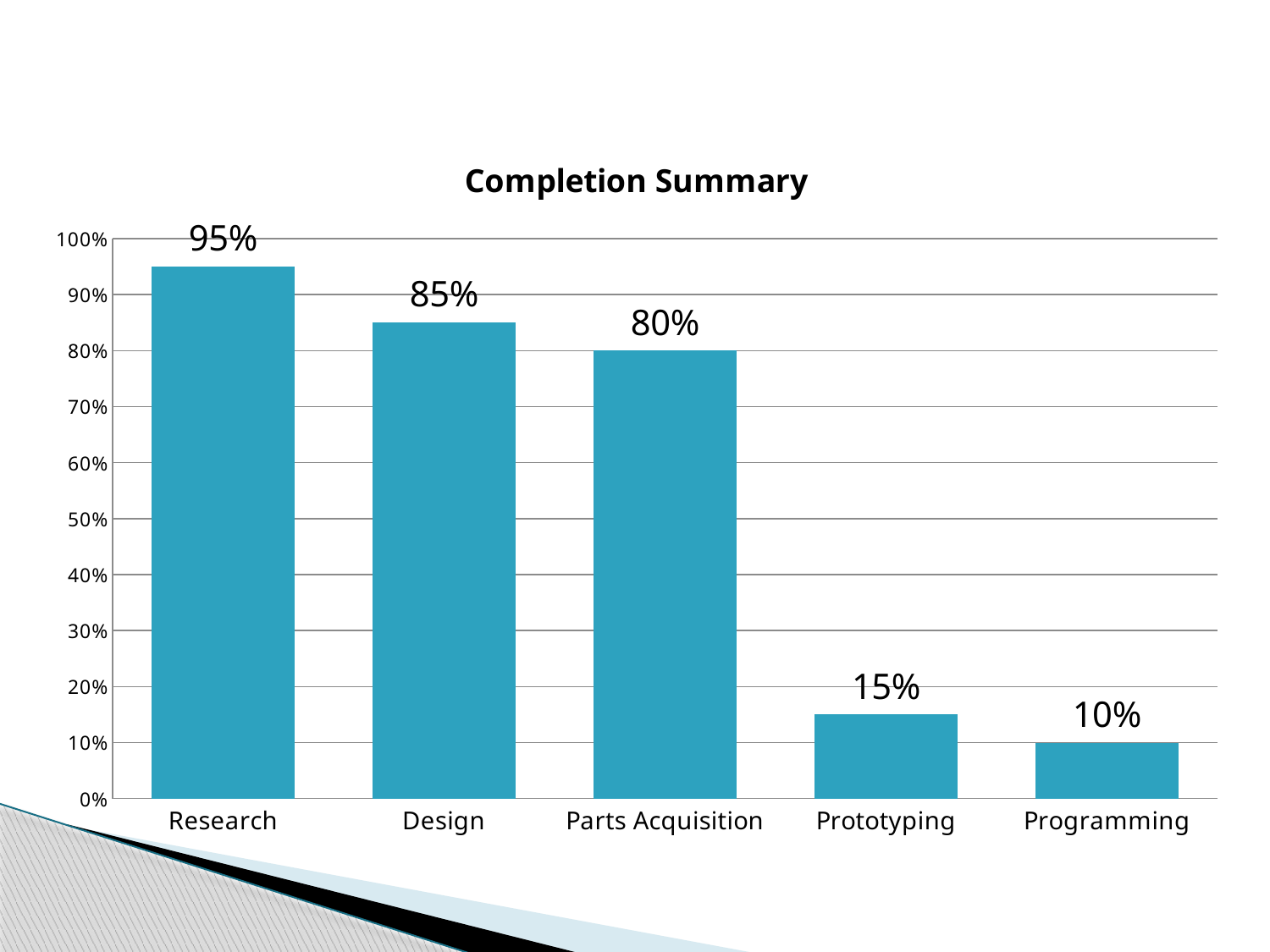
Which is larger, the value for Design or the value for Prototyping? Design What is the completion value for Parts Acquisition? 80% Which category has the highest completion value? Research What is the difference between the values for Design and Parts Acquisition? 5% What is the completion value for Prototyping? 15% What is the title of the chart? Completion Summary How many categories are shown on the x axis? 5 Which category has the lowest completion value? Programming What kind of chart is shown on the slide? bar chart Is the value for Parts Acquisition greater or less than 50%? greater What is the difference between the values for Research and Programming? 85% What is the completion value for Research? 95%